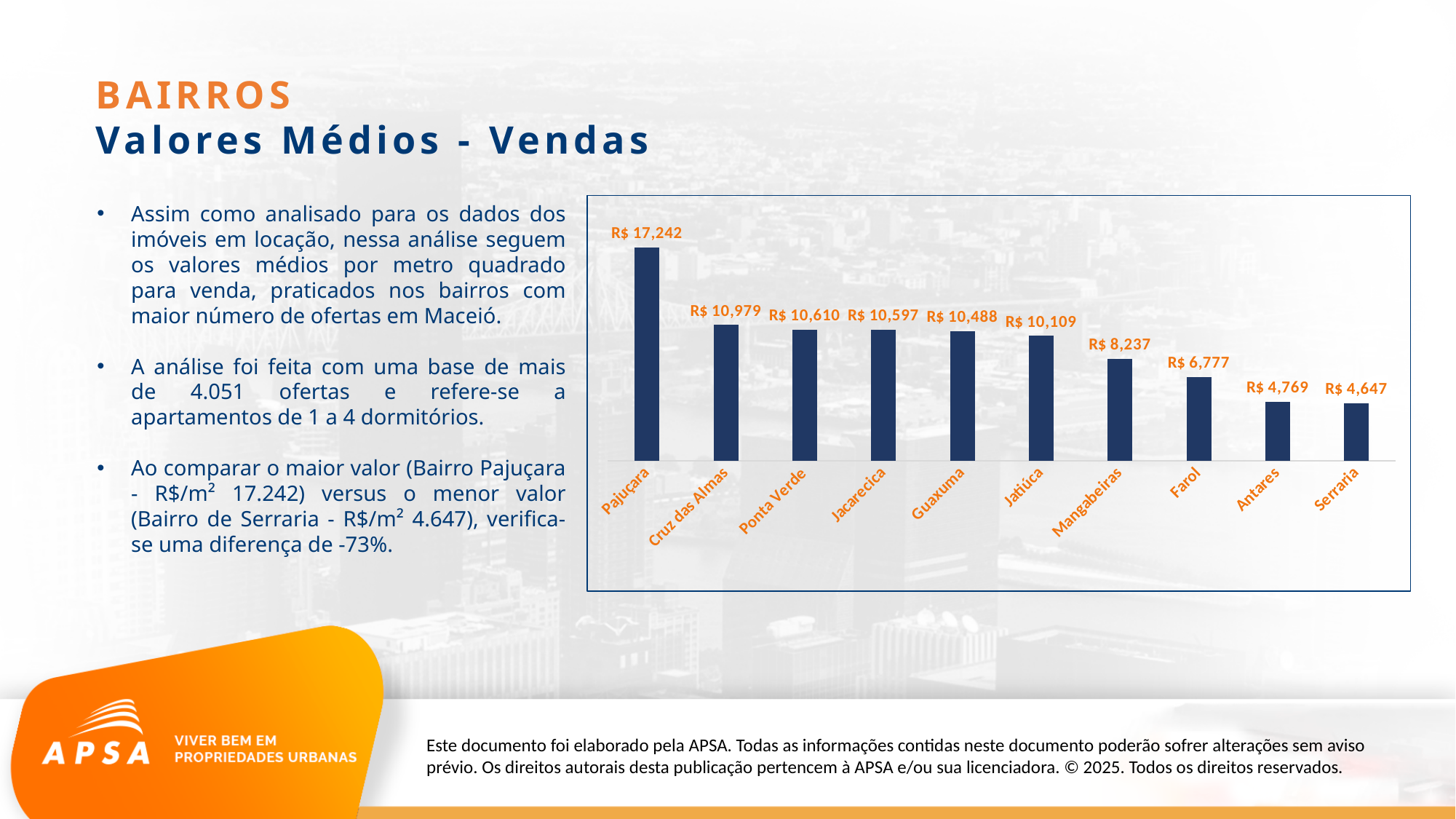
What kind of chart is shown on the slide? Bar chart Which has a larger value, Mangabeiras or Farol? Mangabeiras What is the value shown for Mangabeiras? R$ 8,237 What is the difference between the values for Pajuçara and Serraria? R$ 12,595 What is the value shown for Farol? R$ 6,777 What is the difference between the values for Cruz das Almas and Ponta Verde? R$ 369 What is the value shown for Pajuçara? R$ 17,242 How many neighbourhoods are shown in the chart? 10 Which neighbourhood has the highest value in the chart? Pajuçara Which neighbourhood has the lowest value in the chart? Serraria What is the value shown for Jatiúca? R$ 10,109 Do the values rise or fall from left to right across the chart? Fall